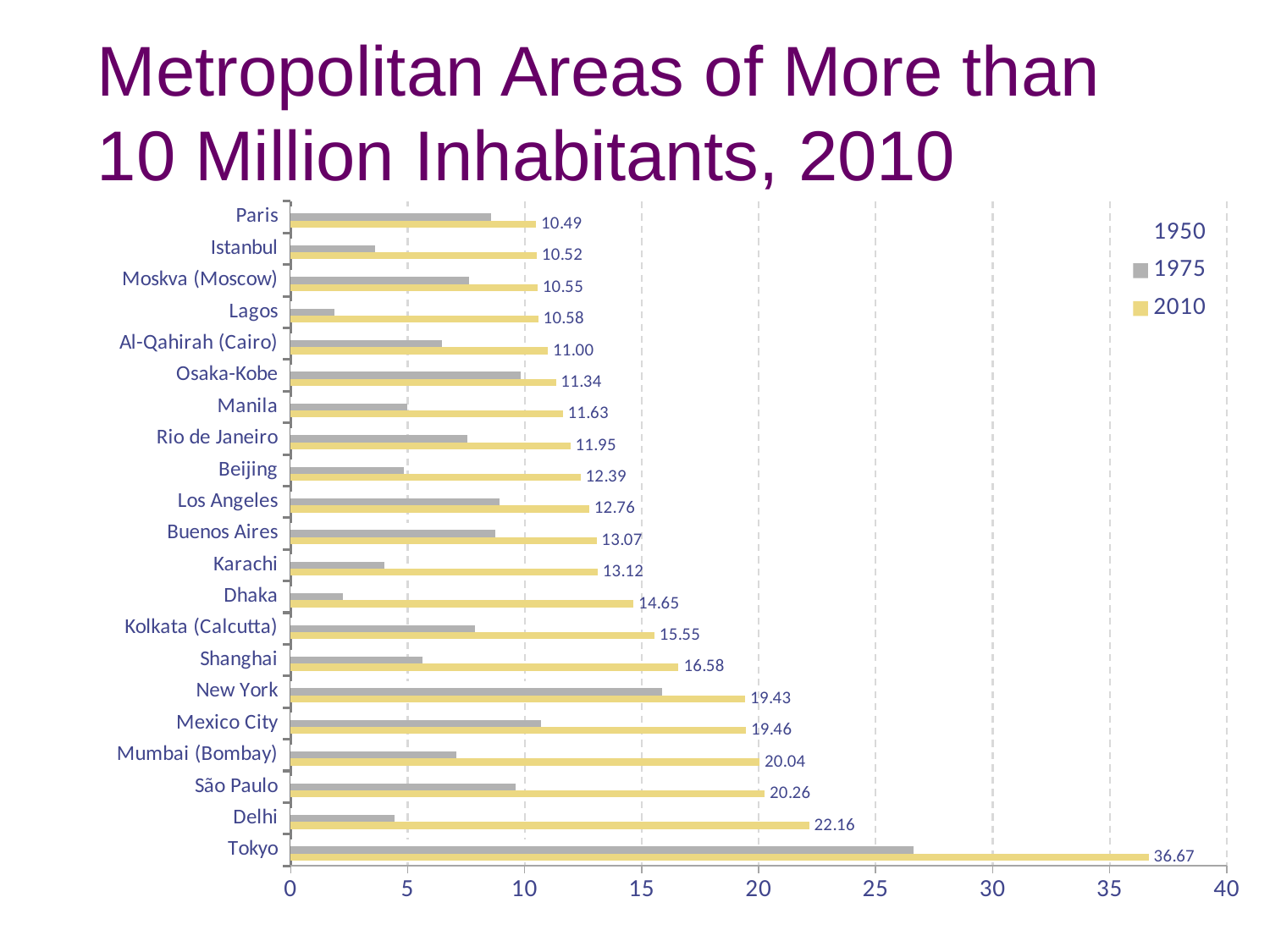
Which metropolitan area has the highest 2010 value? Tokyo How many metropolitan areas are listed on the chart? 21 What kind of chart is shown on the slide? bar chart What is the 2010 value for Delhi? 22.16 Which has the larger 2010 value, Dhaka or Kolkata (Calcutta)? Kolkata (Calcutta) What is the difference between the 2010 values for Tokyo and Delhi? 14.51 What is the difference between the 2010 values for Mumbai (Bombay) and New York? 0.61 Which metropolitan area has the lowest 2010 value? Paris How many series does the legend list? 3 Is the 1975 value for Lagos greater or less than 5? less What is the 2010 value for Shanghai? 16.58 What is the 2010 value for Tokyo? 36.67